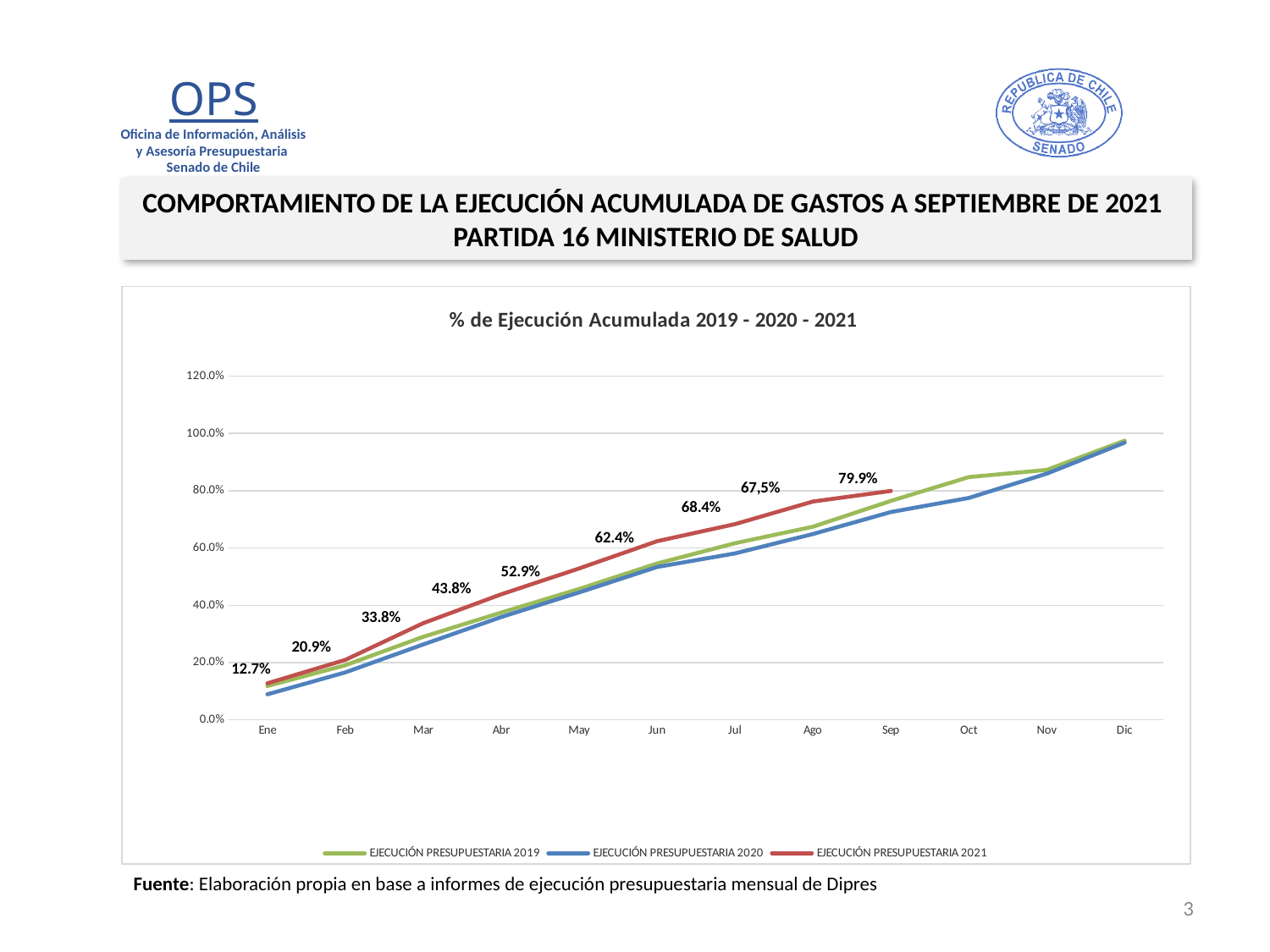
How many series does the legend list? 3 What is the labelled value for EJECUCIÓN PRESUPUESTARIA 2021 in Jun? 62.4% What is the labelled value for EJECUCIÓN PRESUPUESTARIA 2021 in Ene? 12.7% How many months are shown along the x axis? 12 What is the difference between the 2021 labelled values for Sep and Ene? 67.2 percentage points Is the value for EJECUCIÓN PRESUPUESTARIA 2020 in Ene greater or less than 20.0%? less What is the labelled value for EJECUCIÓN PRESUPUESTARIA 2021 in Sep? 79.9% In Sep, which series is higher: EJECUCIÓN PRESUPUESTARIA 2021 or EJECUCIÓN PRESUPUESTARIA 2020? EJECUCIÓN PRESUPUESTARIA 2021 What is the labelled value for EJECUCIÓN PRESUPUESTARIA 2021 in Mar? 33.8% What is the title of the chart? % de Ejecución Acumulada 2019 - 2020 - 2021 Do the values for EJECUCIÓN PRESUPUESTARIA 2021 rise or fall from Ene to Sep? rise What kind of chart is shown on the slide? line chart